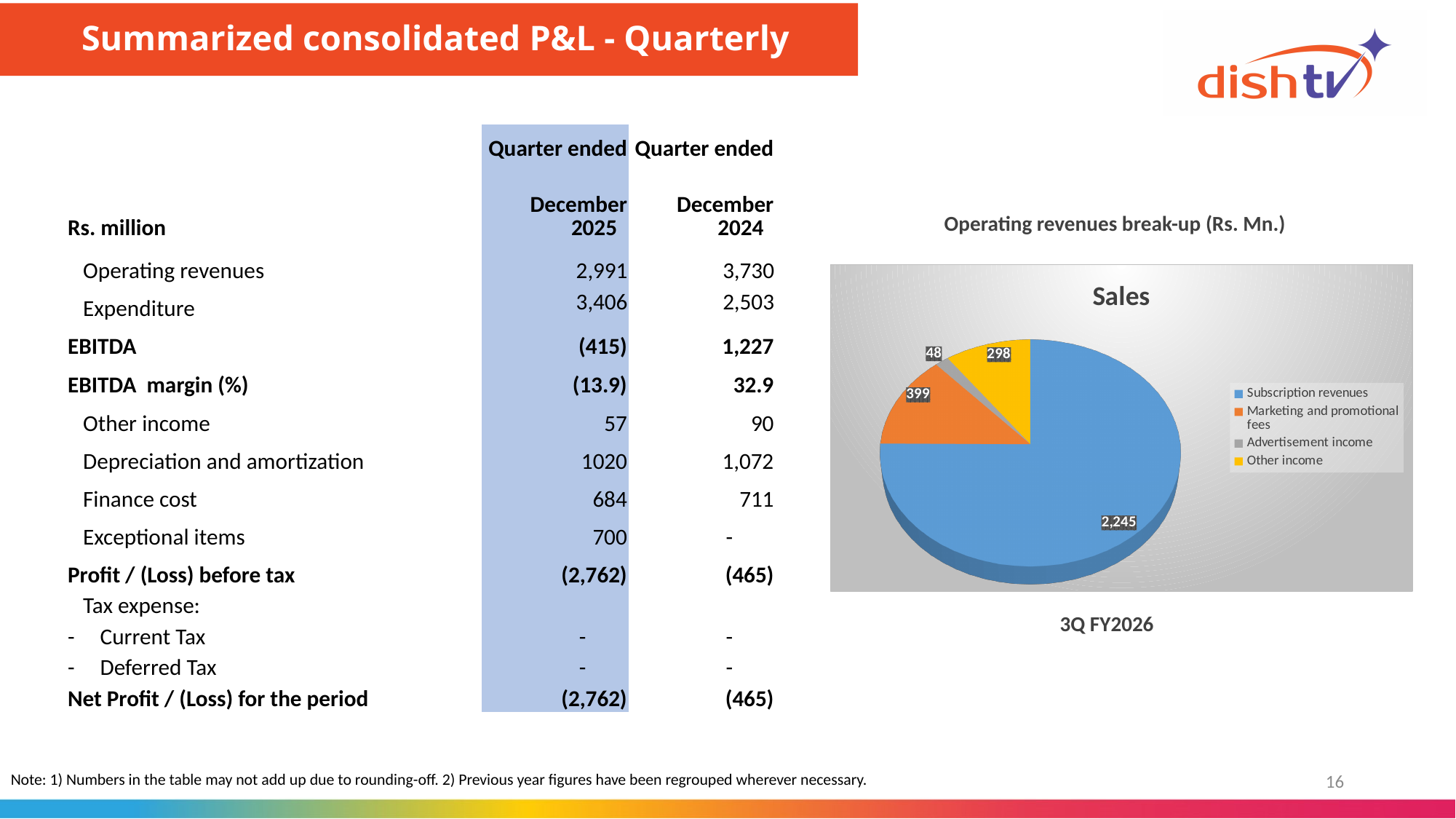
What is the value of the Other income slice in the pie chart? 298 What colour represents Subscription revenues in the pie chart? Blue What is the value of the Marketing and promotional fees slice in the pie chart? 399 What type of chart is used to show the operating revenues break-up? Pie chart How many slices does the pie chart have? 4 Which category has the smallest slice in the pie chart? Advertisement income What is the difference between the Marketing and promotional fees slice and the Other income slice in the pie chart? 101 By how much does the Subscription revenues slice exceed the Marketing and promotional fees slice in the pie chart? 1,846 Which category has the largest slice in the pie chart? Subscription revenues Which is larger in the pie chart: Marketing and promotional fees or Other income? Marketing and promotional fees What is the value of the Advertisement income slice in the pie chart? 48 What is the value of the Subscription revenues slice in the pie chart? 2,245